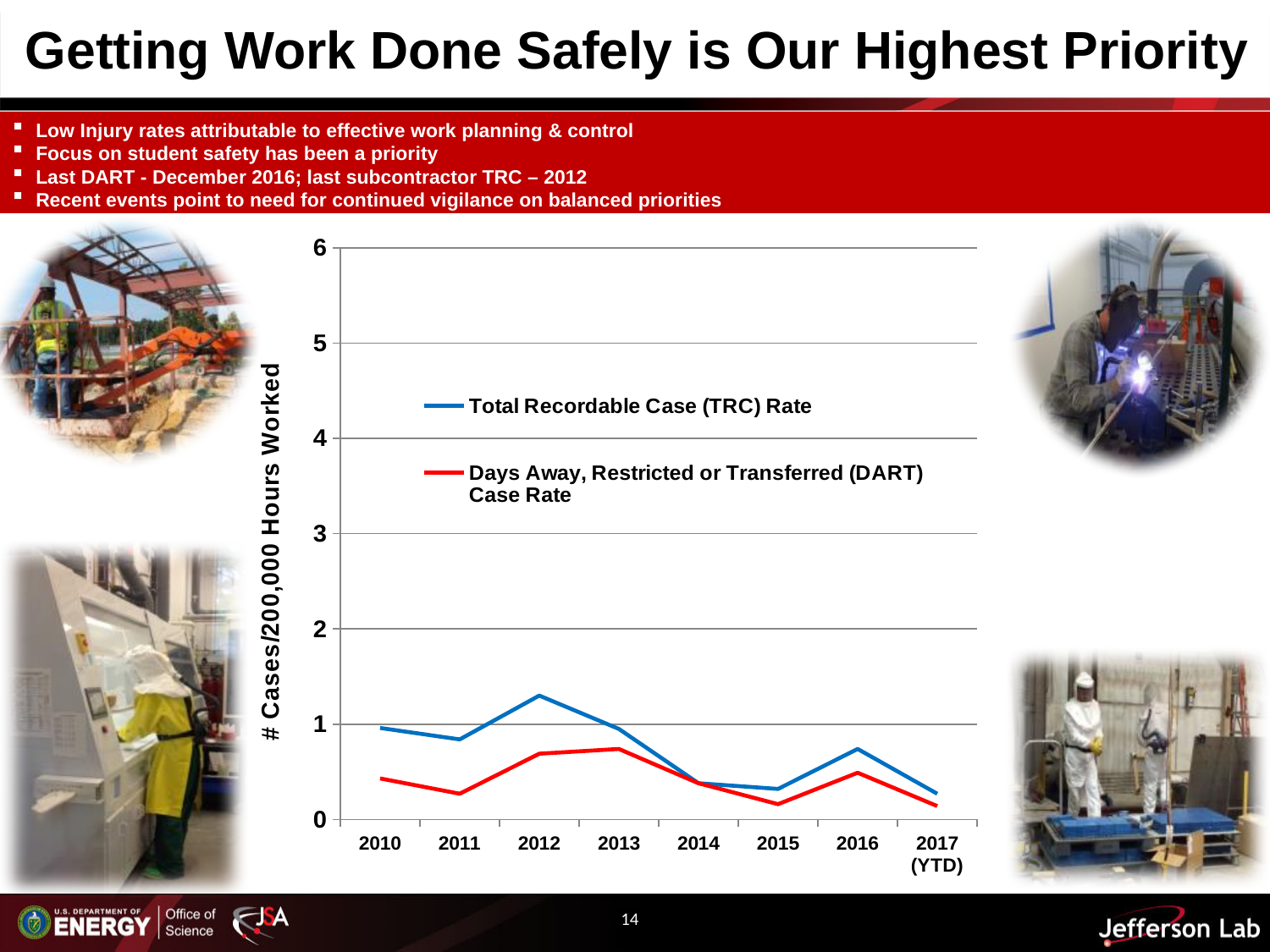
How many years are plotted along the x axis of the chart? 8 How many series does the chart's legend list? 2 In which year is the Total Recordable Case (TRC) Rate highest? 2012 What kind of chart is shown on the slide? line chart In 2012, which is larger: the TRC Rate or the DART Case Rate? TRC Rate Is the Total Recordable Case (TRC) Rate for 2012 greater or less than 1? greater What colour is the line for the Days Away, Restricted or Transferred (DART) Case Rate? red Does the Total Recordable Case (TRC) Rate rise or fall from 2013 to 2014? fall What is the label on the y axis of the chart? # Cases/200,000 Hours Worked Is the DART Case Rate for 2013 greater or less than 1? less Is the Total Recordable Case (TRC) Rate for 2015 greater or less than 1? less Which is larger: the TRC Rate in 2012 or the TRC Rate in 2016? 2012